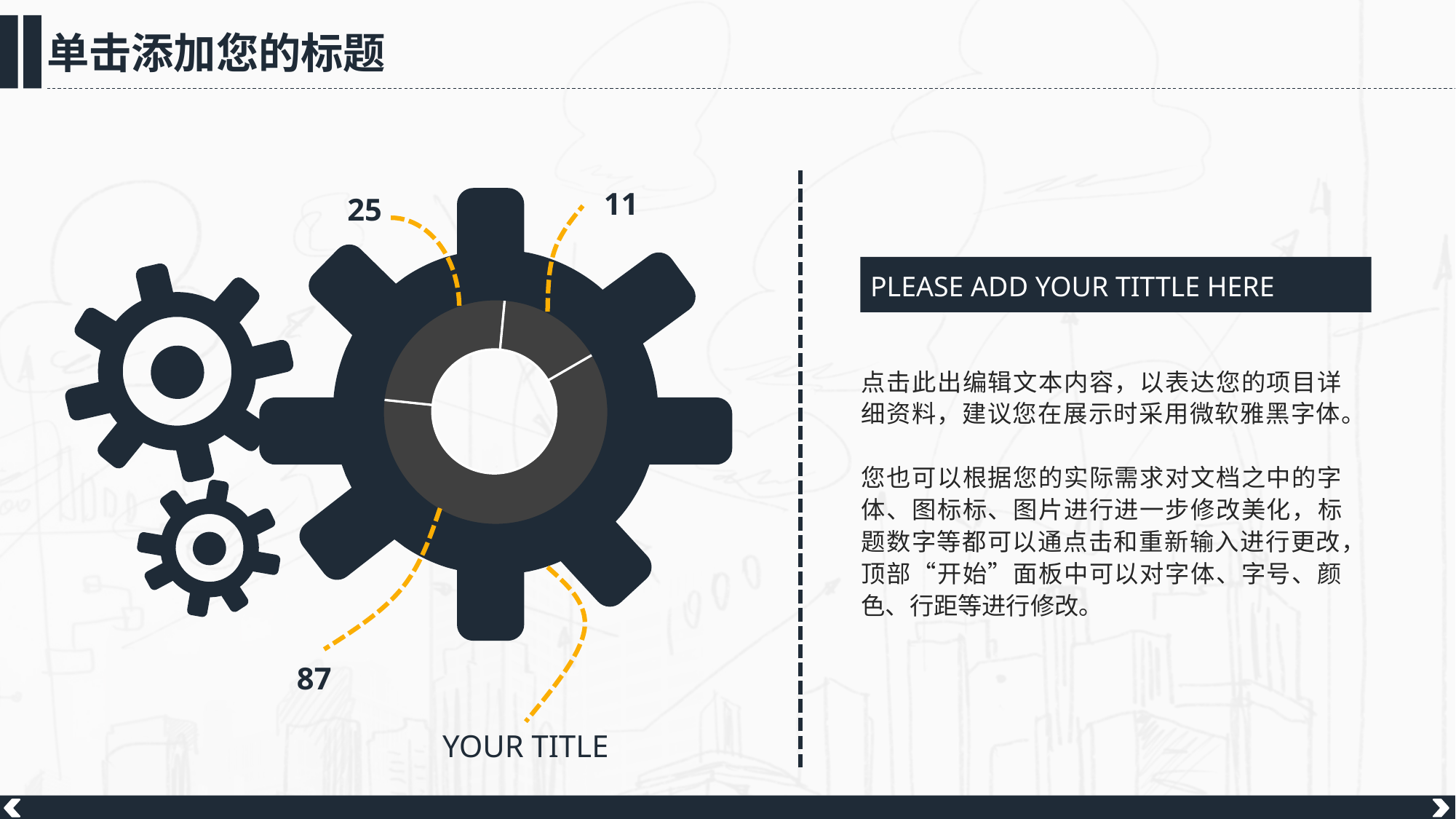
What title is printed below the doughnut chart? YOUR TITLE What is the difference between the values 25 and 11 on the doughnut chart? 14 What is the smallest value labelled on the doughnut chart? 11 What kind of chart is shown inside the large gear? doughnut chart Which is larger on the doughnut chart, the slice labelled 25 or the slice labelled 11? 25 What is the difference between the largest and smallest values on the doughnut chart? 76 What value is labelled at the bottom left of the doughnut chart? 87 What is the total of the three values labelled on the doughnut chart? 123 What value is labelled at the top right of the doughnut chart? 11 How many slices does the doughnut chart have? 3 What value is labelled at the top left of the doughnut chart? 25 What is the largest value labelled on the doughnut chart? 87